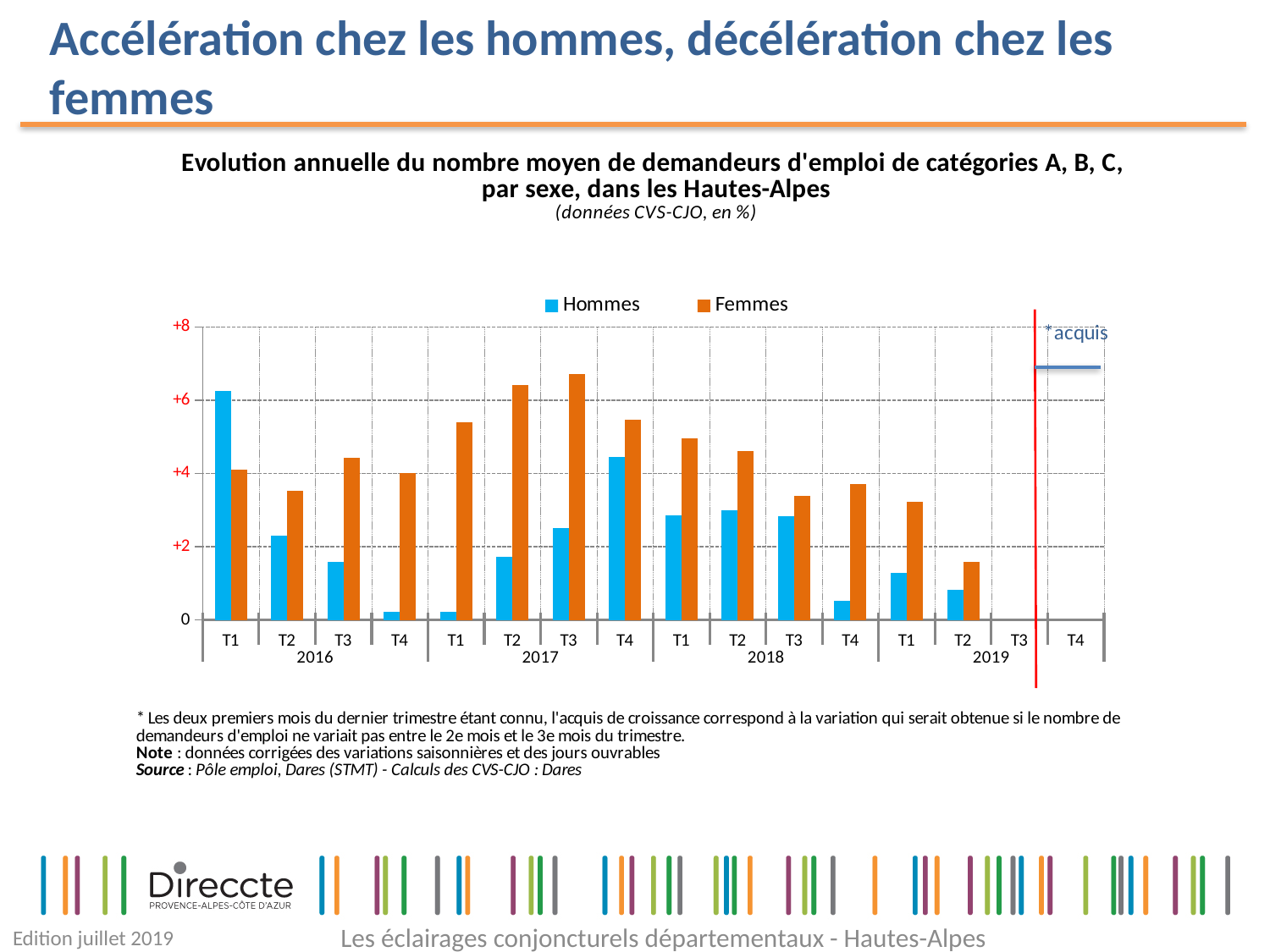
In which quarter is the Hommes value highest? T1 2016 Is the Hommes value for T4 2016 greater or less than +2? less What kind of chart is shown on the slide? bar chart Which colour represents the Femmes series in the chart? orange Is the Hommes value for T1 2016 greater or less than +6? greater How many series does the chart legend list? 2 Is the Femmes value for T3 2017 greater or less than +6? greater For T1 2016, which is larger, the Hommes value or the Femmes value? Hommes In which quarter is the Femmes value lowest? T2 2019 Do the Femmes values rise or fall from T3 2017 to T2 2019? fall Which two series are shown in the chart legend? Hommes and Femmes